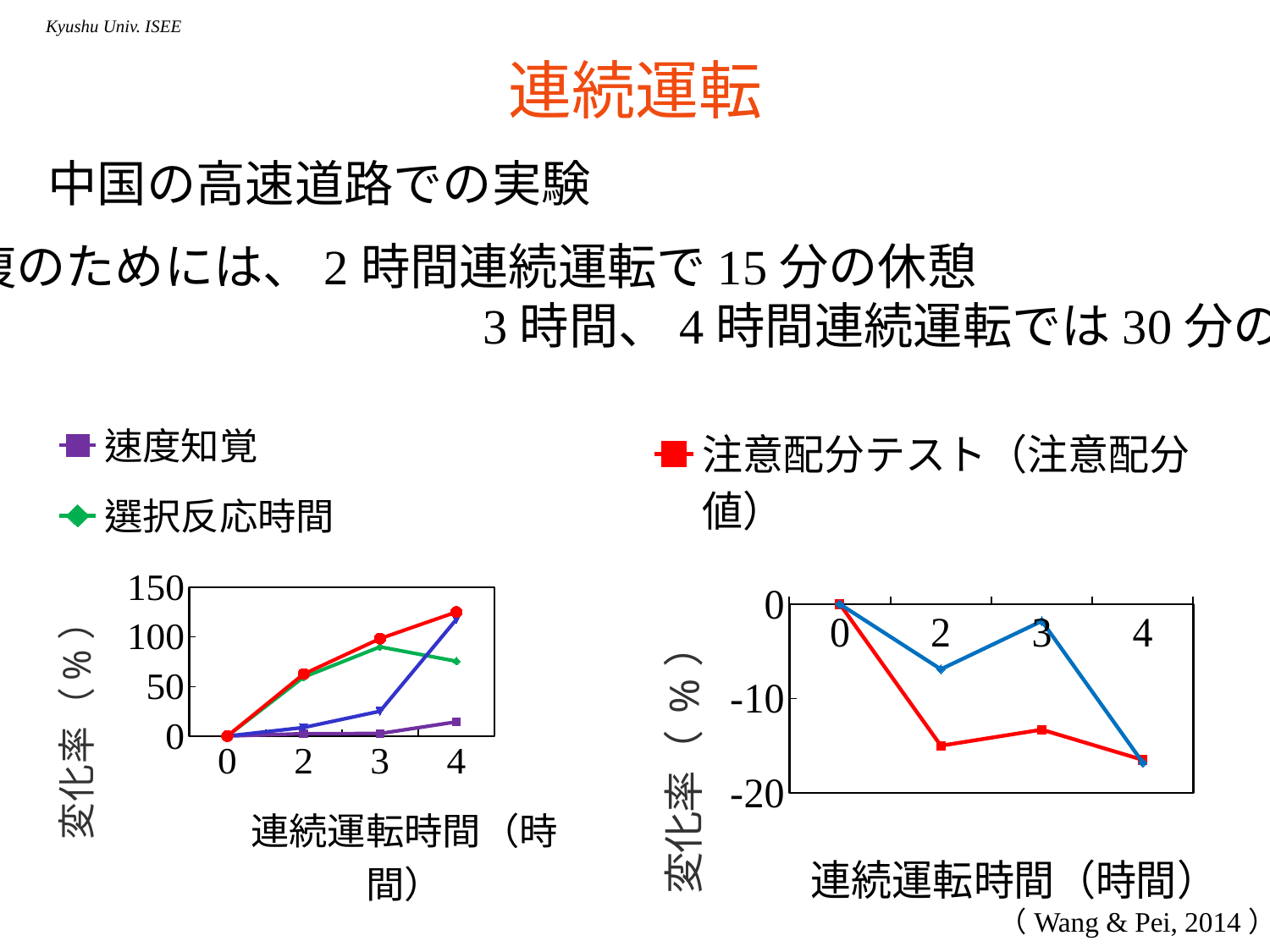
In the right chart, is the value for 注意配分テスト at 2 hours greater or less than -10? less In the left chart, is the value for 選択反応時間 at 3 hours greater or less than 50? greater In the left chart, does the 速度知覚 series rise or fall from 0 to 4 hours? rise What is the y-axis label of the right chart? 変化率（%） In the right chart, how many points along the x axis (連続運転時間) are plotted for each series? 4 What kind of chart is the left chart on the slide? line chart In the left chart, is the value for 速度知覚 at 4 hours greater or less than 50? less In the right chart, does the 注意配分テスト series rise or fall from 0 to 4 hours? fall How many series does the legend above the left chart list? 2 In the left chart, how many points along the x axis (連続運転時間) are plotted for each series? 4 What kind of chart is the right chart on the slide? line chart